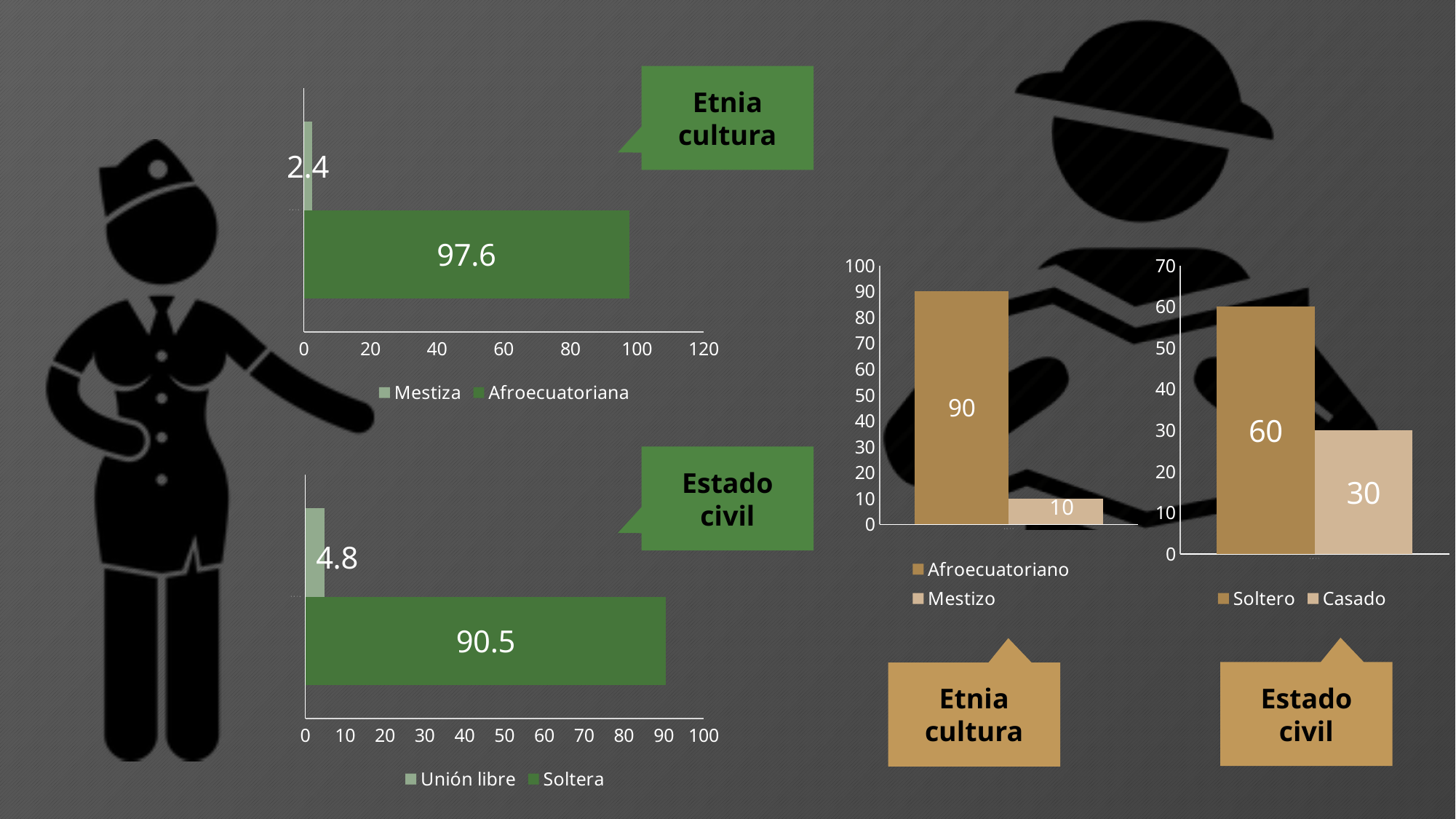
In the bottom-left 'Estado civil' chart, what is the difference between Soltera and Unión libre? 85.7 In the right-hand 'Estado civil' chart, what is the difference between Soltero and Casado? 30 In the right-hand 'Estado civil' chart, which is larger, Soltero or Casado? Soltero How many series does the legend of the bottom-left 'Estado civil' chart list? 2 In the right-hand 'Etnia cultura' chart, what is the value for Mestizo? 10 In the right-hand 'Etnia cultura' chart, what is the value for Afroecuatoriano? 90 What kind of chart is the right-hand 'Etnia cultura' chart? Bar chart In the top-left 'Etnia cultura' chart, what is the value for Afroecuatoriana? 97.6 In the right-hand 'Estado civil' chart, what is the value for Casado? 30 In the bottom-left 'Estado civil' chart, what is the value for Unión libre? 4.8 In the top-left 'Etnia cultura' chart, what is the value for Mestiza? 2.4 In the bottom-left 'Estado civil' chart, what is the value for Soltera? 90.5